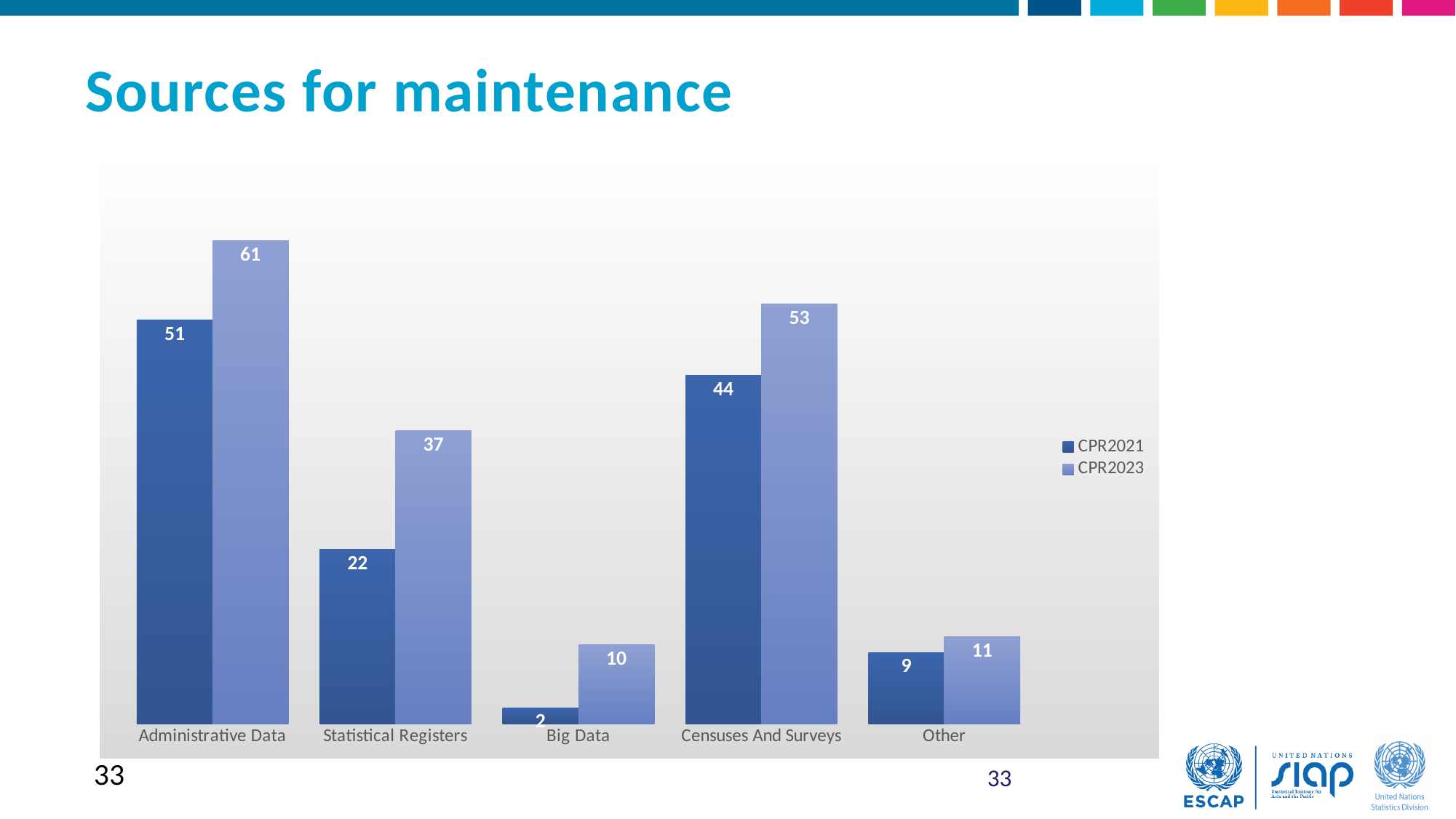
What is the CPR2021 value for Administrative Data? 51 What kind of chart is shown on the slide? Bar chart What is the CPR2021 value for Big Data? 2 What is the difference between the CPR2023 and CPR2021 values for Statistical Registers? 15 Which category has the highest CPR2023 value? Administrative Data How many categories are shown on the x axis? 5 Which is larger: the CPR2021 value for Censuses And Surveys or the CPR2023 value for Statistical Registers? CPR2021 value for Censuses And Surveys How many series does the legend list? 2 What is the CPR2023 value for Censuses And Surveys? 53 What is the title of the slide? Sources for maintenance What is the CPR2023 value for Statistical Registers? 37 Which category has the lowest CPR2021 value? Big Data